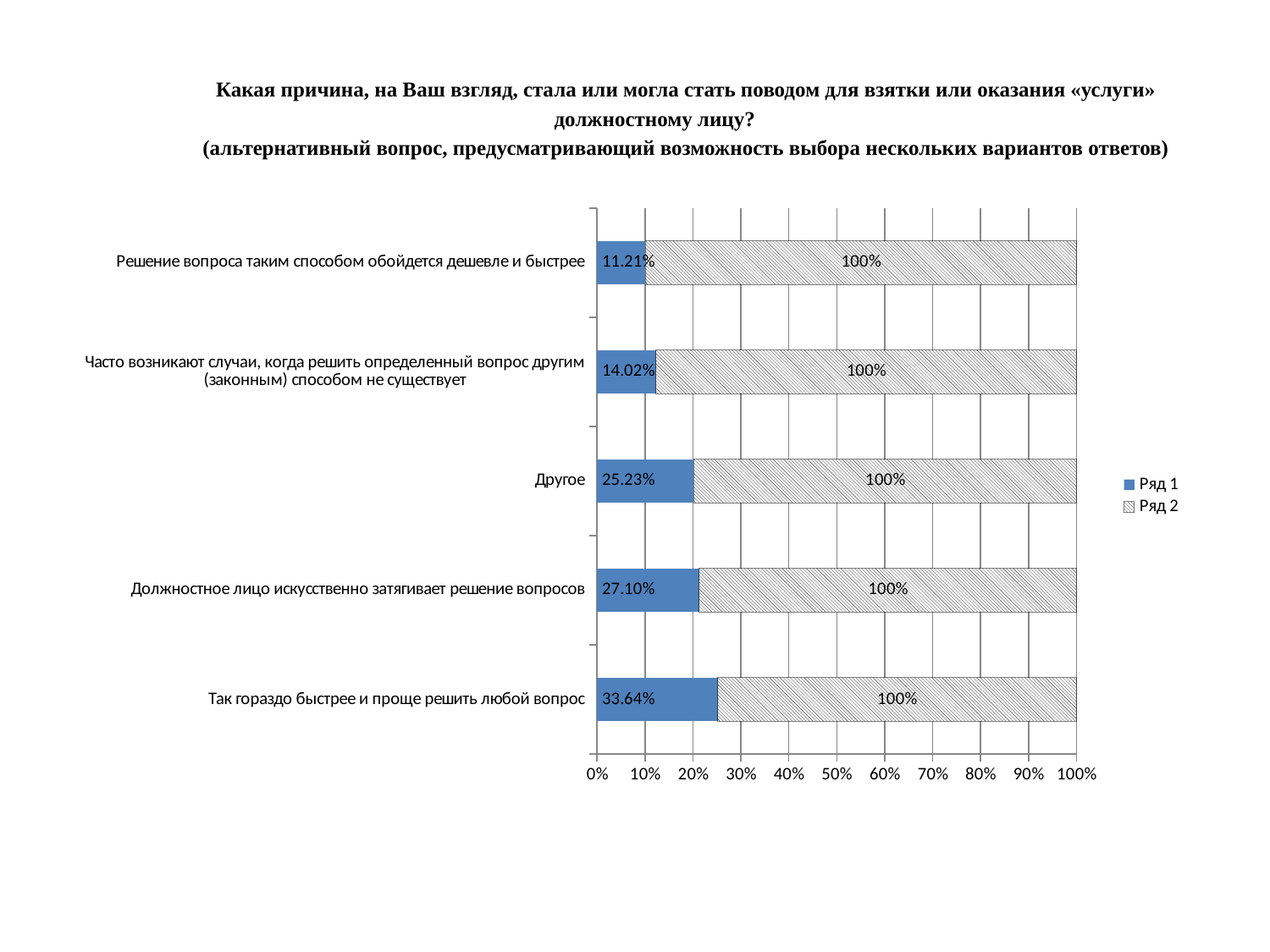
What are the names of the two series in the legend? Ряд 1 and Ряд 2 How many categories are shown on the chart? 5 What is the difference between the Ряд 1 values for "Так гораздо быстрее и проще решить любой вопрос" and "Решение вопроса таким способом обойдется дешевле и быстрее"? 22.43% What is the Ряд 1 value for "Так гораздо быстрее и проще решить любой вопрос"? 33.64% What type of chart is shown on the slide? bar chart Which category has the lowest Ряд 1 value? Решение вопроса таким способом обойдется дешевле и быстрее Which category has the highest Ряд 1 value? Так гораздо быстрее и проще решить любой вопрос What is the Ряд 1 value for "Часто возникают случаи, когда решить определенный вопрос другим (законным) способом не существует"? 14.02% What is the Ряд 1 value for "Другое"? 25.23% Which has the larger Ряд 1 value: "Другое" or "Должностное лицо искусственно затягивает решение вопросов"? Должностное лицо искусственно затягивает решение вопросов How many series does the legend list? 2 What is the Ряд 1 value for "Должностное лицо искусственно затягивает решение вопросов"? 27.10%